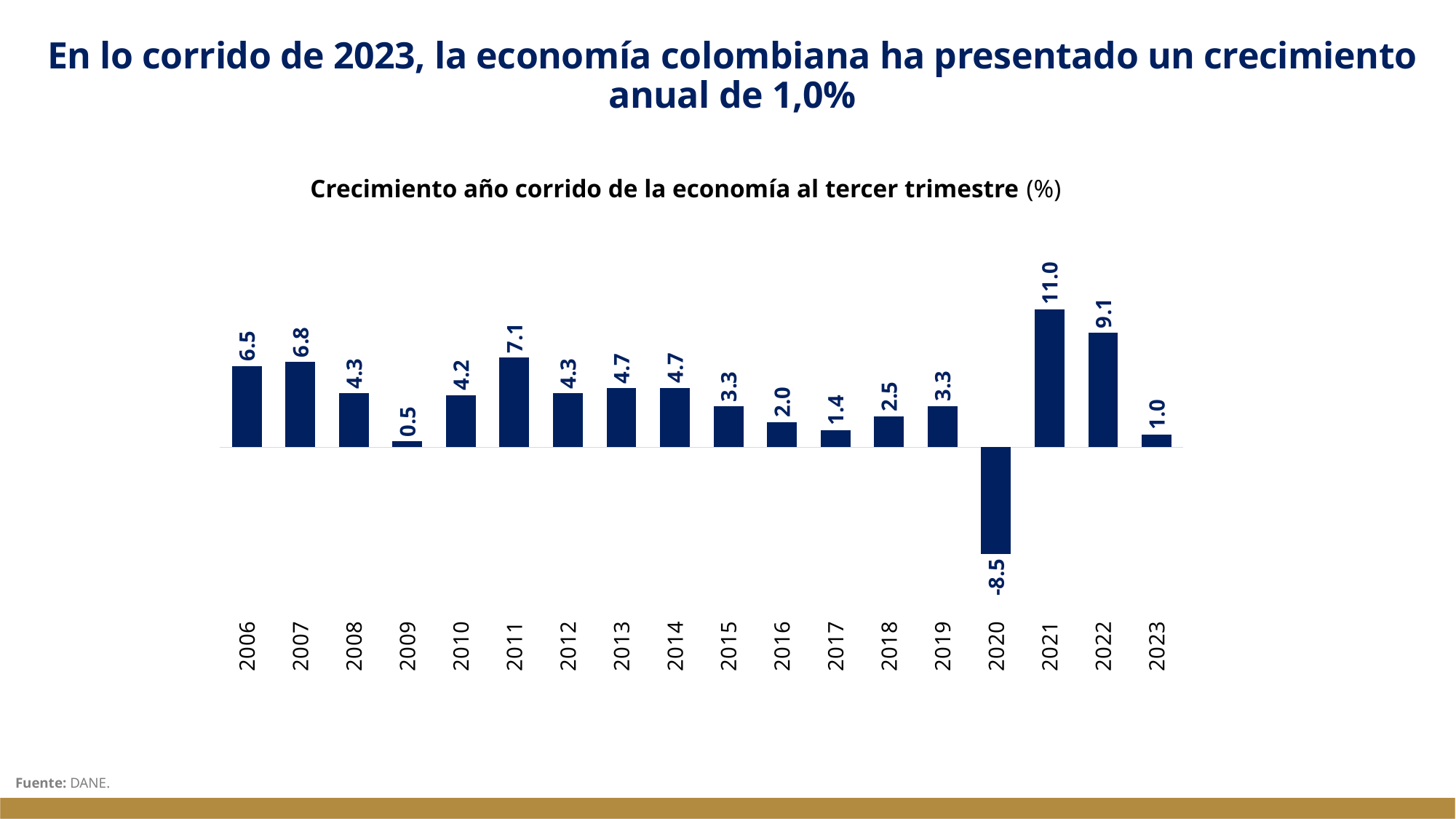
What is the value for 2023? 1.0 How many years are shown on the x axis? 18 What is the difference between the values for 2021 and 2022? 1.9 What is the value for 2021? 11.0 What is the title of the chart? Crecimiento año corrido de la economía al tercer trimestre (%) What is the value for 2009? 0.5 Which year has the highest value? 2021 Which is larger, the value for 2006 or the value for 2007? 2007 Which year has the lowest value? 2020 What is the value for 2020? -8.5 Do the values rise or fall from 2021 to 2023? Fall What kind of chart is shown? Bar chart